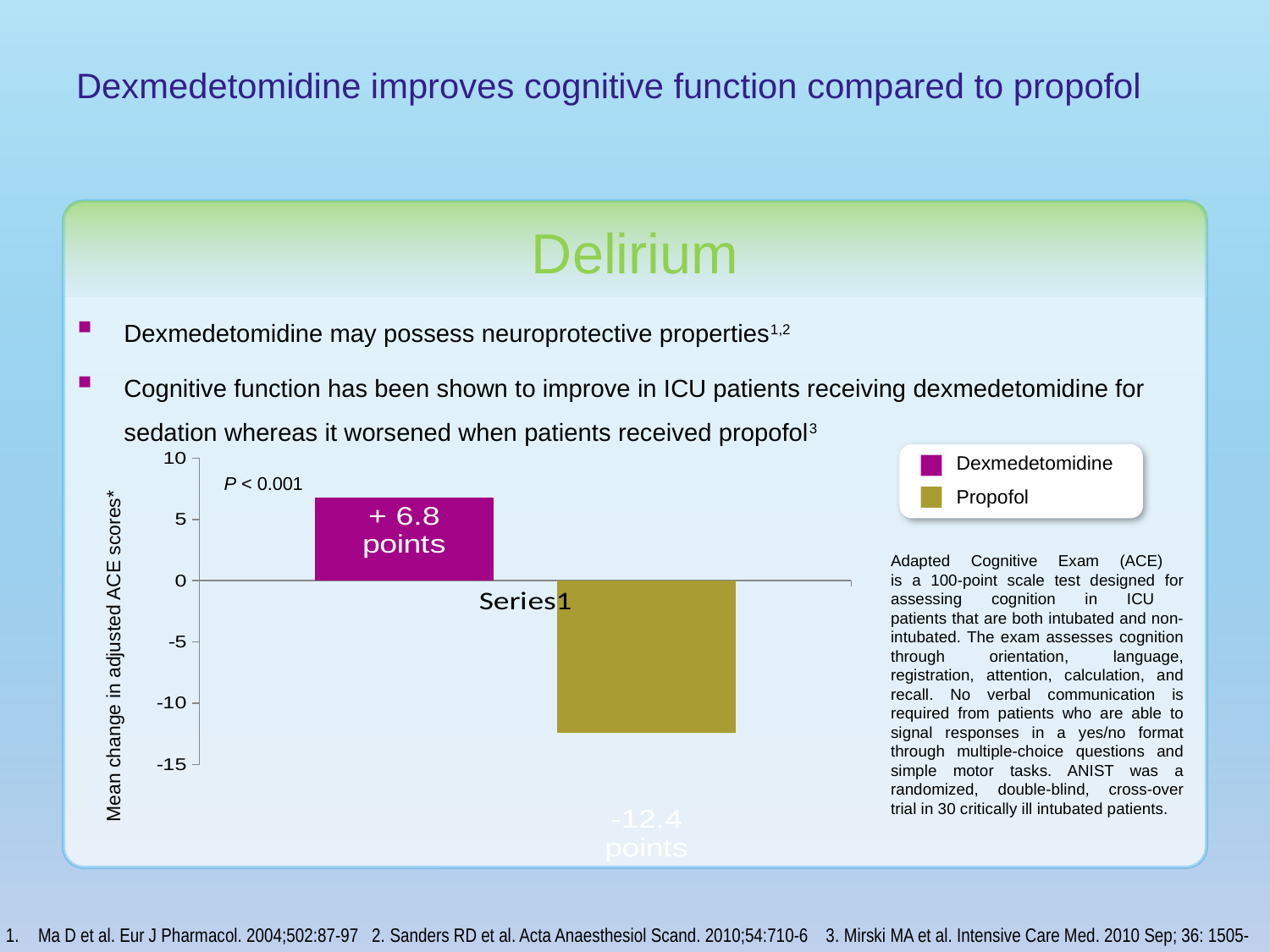
Which treatment has the higher mean change in adjusted ACE score? Dexmedetomidine Is the value for propofol greater or less than -10? less What is the label of the vertical axis of the chart? Mean change in adjusted ACE scores* What P value is shown on the chart? P < 0.001 How many series does the chart legend list? 2 Which treatment has the lowest mean change in adjusted ACE score? Propofol Is the value for dexmedetomidine greater or less than 5? greater What is the mean change in adjusted ACE score for propofol? -12.4 points What is the difference between the dexmedetomidine and propofol mean changes in adjusted ACE score? 19.2 points What is the mean change in adjusted ACE score for dexmedetomidine? + 6.8 points What kind of chart is shown on the slide? Bar chart